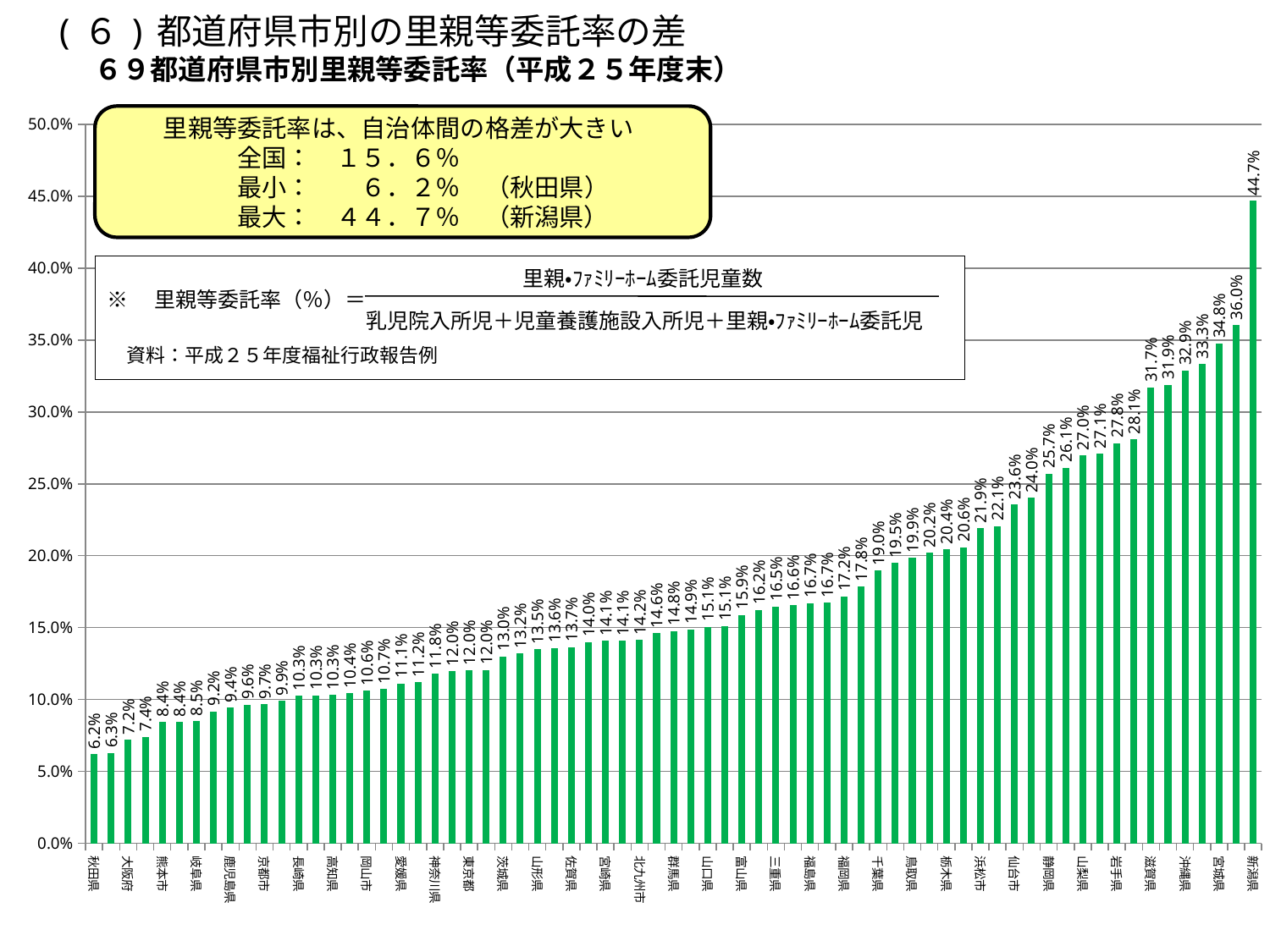
What is the foster care placement rate for 秋田県? 6.2% Which has a higher rate, 新潟県 or 宮城県? 新潟県 What kind of chart is shown on the slide? bar chart What is the foster care placement rate for 新潟県? 44.7% Do the bar values rise or fall from left to right along the x axis? rise Is the value for 宮城県 greater or less than 30.0%? greater Which prefecture or city has the lowest foster care placement rate in the chart? 秋田県 What is the difference between the rates for 新潟県 and 秋田県? 38.5% Which prefecture or city has the highest foster care placement rate (里親等委託率) in the chart? 新潟県 How many prefectures and cities are plotted in the chart, according to the chart title? 69 What is the national (全国) foster care placement rate stated in the yellow box on the chart? 15.6% Is the value for 大阪府 greater or less than 10.0%? less